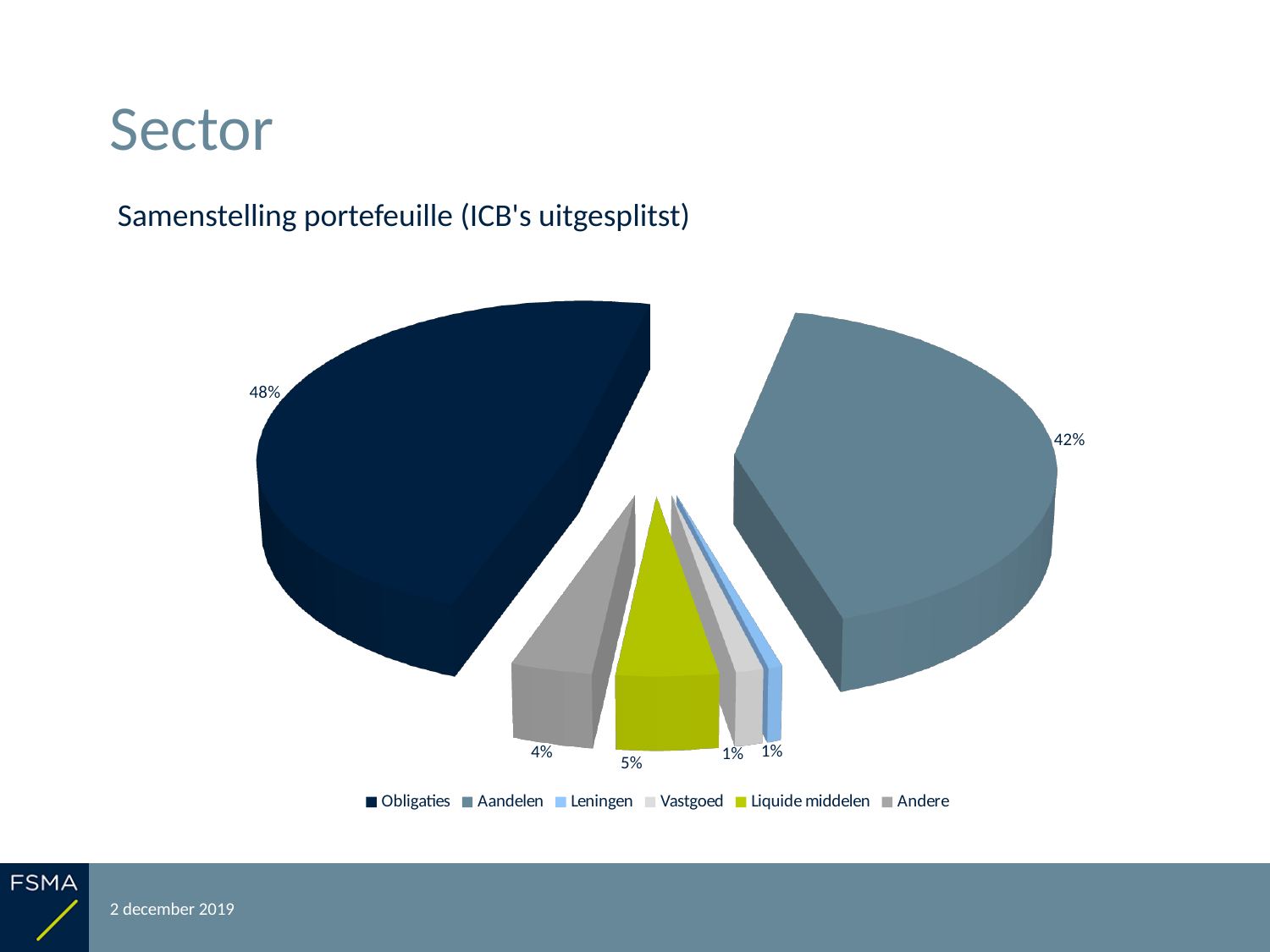
What share of the portfolio is Andere? 4% What is the difference in percentage points between the Obligaties share and the Aandelen share? 6 percentage points Which has the larger share, Liquide middelen or Andere? Liquide middelen What is the title of the chart? Samenstelling portefeuille (ICB's uitgesplitst) What share of the portfolio is Liquide middelen? 5% How many entries does the legend list? 6 What is the combined share of Obligaties and Aandelen? 90% Which category has the largest share of the pie? Obligaties What share of the portfolio is Aandelen? 42% How many slices does the pie chart have? 6 What kind of chart is shown on the slide? Pie chart What share of the portfolio is Obligaties? 48%